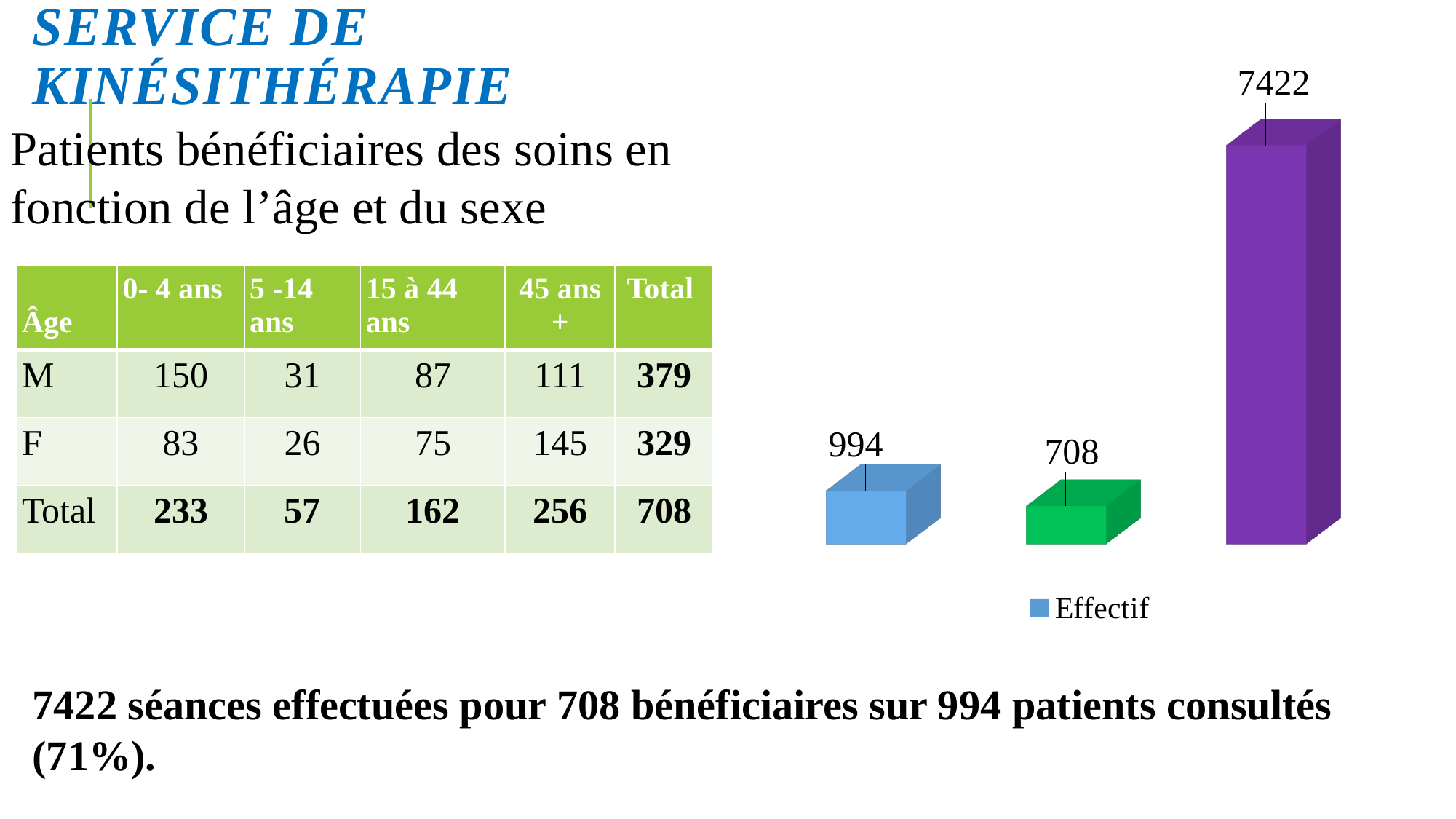
What kind of chart is shown on the right of the slide? bar chart How many series does the chart legend list? 1 What is the name of the series shown in the chart legend? Effectif What value is labelled on the leftmost (blue) bar of the chart? 994 Which bar in the chart has the highest value? the rightmost (purple) bar, 7422 What is the difference between the tallest bar (7422) and the leftmost bar (994) in the chart? 6428 Which is larger in the chart, the leftmost blue bar or the middle green bar? the leftmost blue bar (994) How many bars are plotted in the chart? 3 What is the difference between the leftmost bar (994) and the middle bar (708) in the chart? 286 Which bar in the chart has the lowest value? the middle (green) bar, 708 What value is labelled on the middle (green) bar of the chart? 708 What value is labelled on the tallest (purple) bar of the chart? 7422